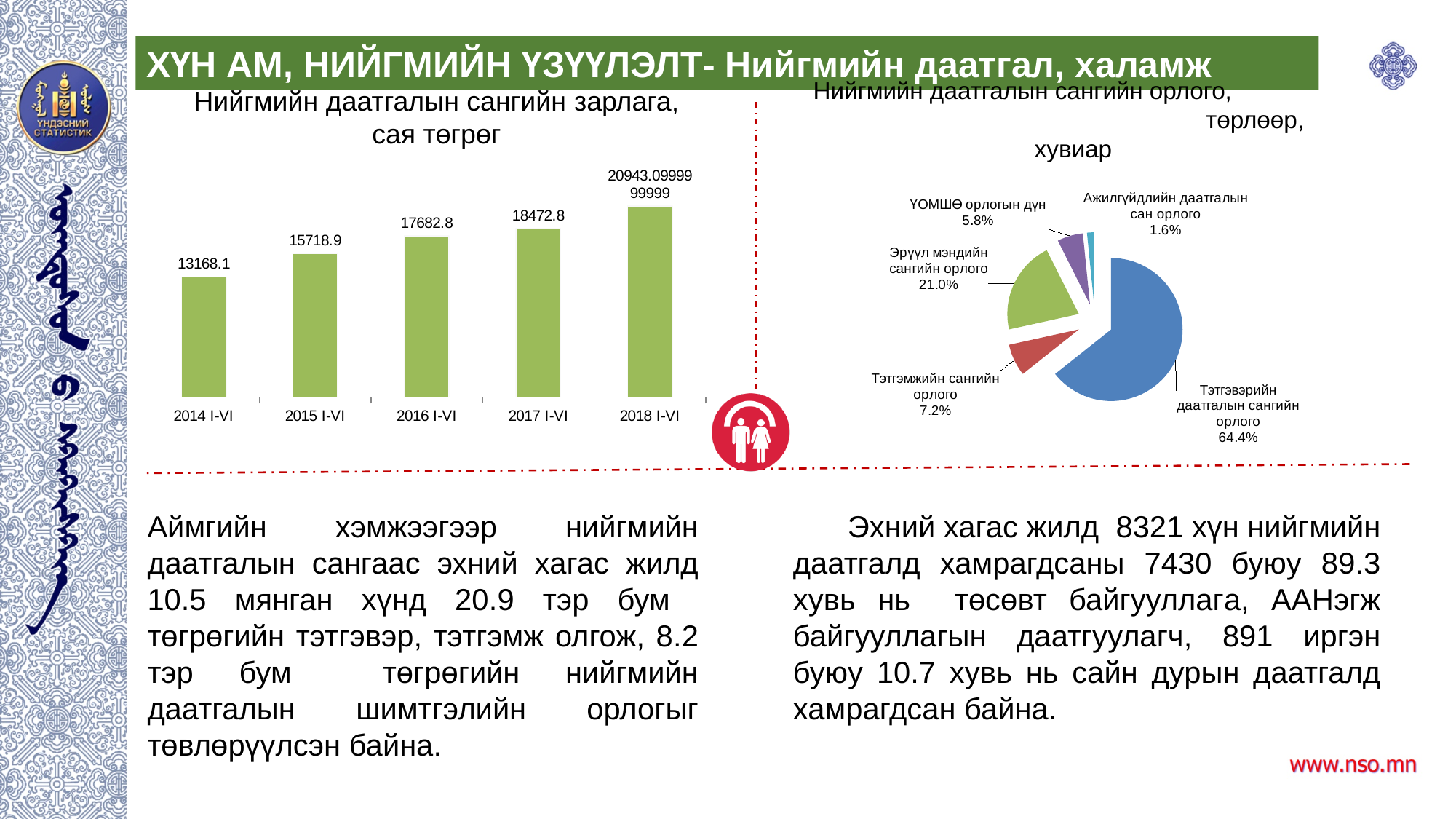
On the pie chart 'Нийгмийн даатгалын сангийн орлого, төрлөөр, хувиар', what share does 'Эрүүл мэндийн сангийн орлого' have? 21.0% On the bar chart 'Нийгмийн даатгалын сангийн зарлага, сая төгрөг', what is the value for 2014 I-VI? 13168.1 On the bar chart 'Нийгмийн даатгалын сангийн зарлага, сая төгрөг', which period has the lowest value? 2014 I-VI On the pie chart 'Нийгмийн даатгалын сангийн орлого, төрлөөр, хувиар', which is larger: 'Тэтгэмжийн сангийн орлого' or 'ҮОМШӨ орлогын дүн'? Тэтгэмжийн сангийн орлого On the bar chart 'Нийгмийн даатгалын сангийн зарлага, сая төгрөг', what is the value for 2017 I-VI? 18472.8 What kind of chart is the one on the right titled 'Нийгмийн даатгалын сангийн орлого, төрлөөр, хувиар'? pie chart On the bar chart 'Нийгмийн даатгалын сангийн зарлага, сая төгрөг', do the values rise or fall from 2014 I-VI to 2018 I-VI? rise On the bar chart 'Нийгмийн даатгалын сангийн зарлага, сая төгрөг', what is the difference between the values for 2017 I-VI and 2016 I-VI? 790.0 On the bar chart 'Нийгмийн даатгалын сангийн зарлага, сая төгрөг', what is the value for 2016 I-VI? 17682.8 On the bar chart 'Нийгмийн даатгалын сангийн зарлага, сая төгрөг', how many periods are shown? 5 On the bar chart 'Нийгмийн даатгалын сангийн зарлага, сая төгрөг', which period has the highest value? 2018 I-VI On the pie chart 'Нийгмийн даатгалын сангийн орлого, төрлөөр, хувиар', which category has the smallest share? Ажилгүйдлийн даатгалын сан орлого